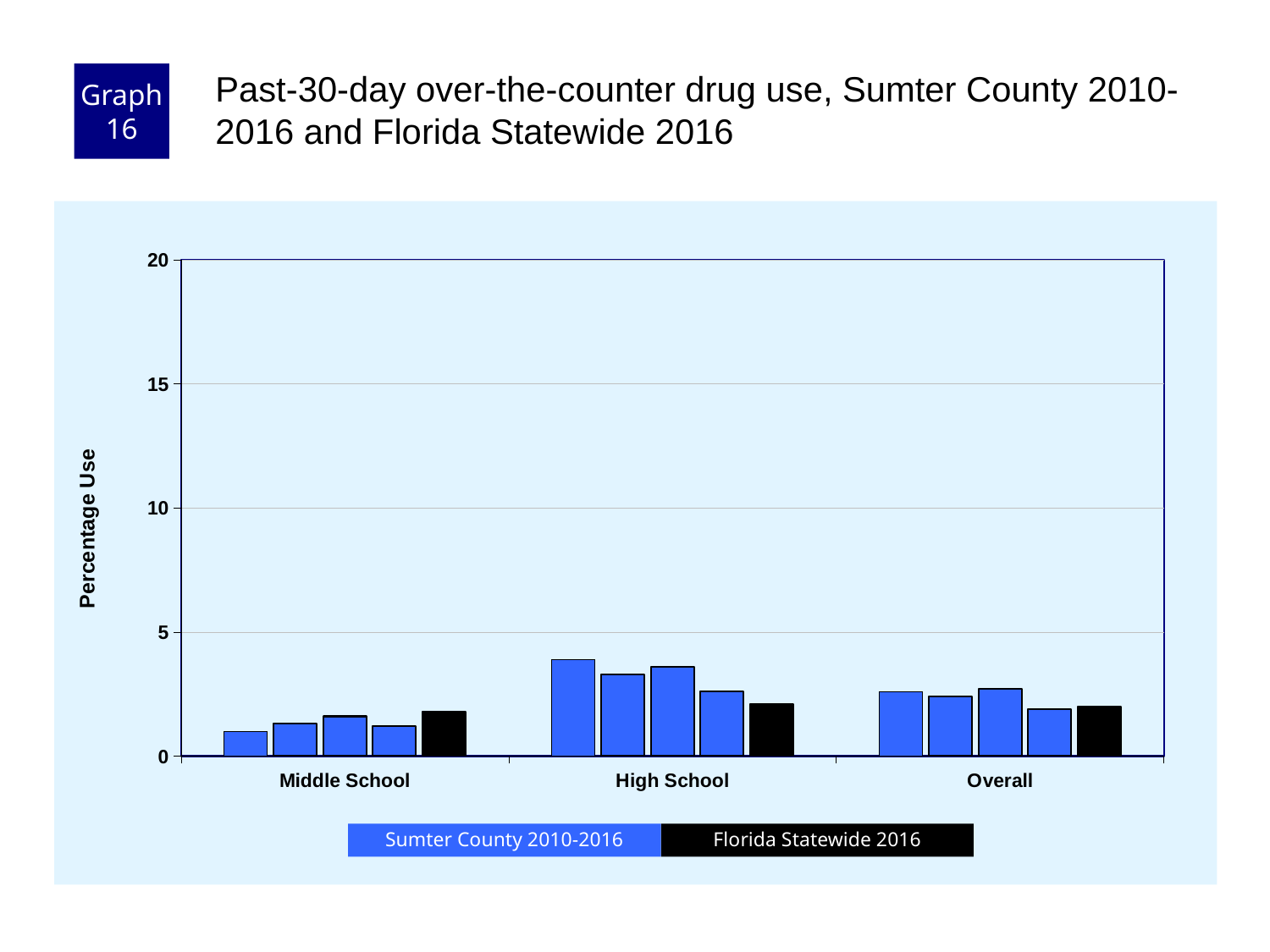
How many categories are shown along the x axis? 3 Which is larger: the Florida Statewide 2016 value for High School or for Middle School? High School What kind of chart is shown on the slide? bar chart Is the Florida Statewide 2016 value for High School greater or less than 5? less How many series does the legend list? 2 Which category has the tallest bars? High School Which colour represents Florida Statewide 2016 in the legend? black Which category has the shortest bars? Middle School Is the Florida Statewide 2016 value for Middle School greater or less than 5? less What is the label on the y axis? Percentage Use Which is larger: the first Sumter County bar for High School or the first Sumter County bar for Middle School? High School Is the tallest Sumter County bar for High School greater or less than 5? less